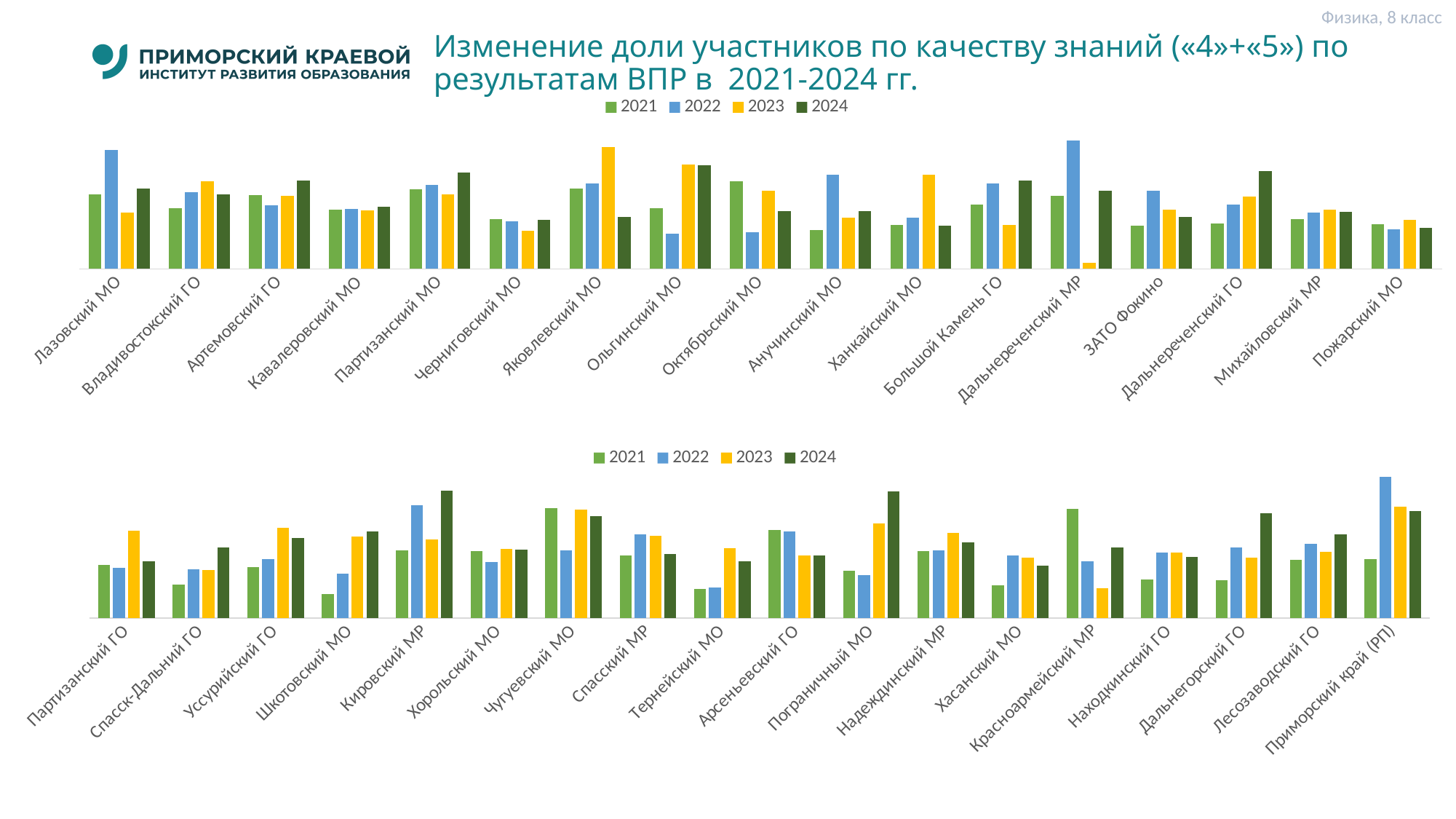
How many categories are shown on the x axis of the top chart? 17 How many series does the legend of the top chart list? 4 In the top chart, which year has the lowest bar for Дальнереченский МР? 2023 How many categories are shown on the x axis of the bottom chart? 18 In the top chart, for Лазовский МО, which is larger: the 2022 value or the 2023 value? 2022 What kind of chart is the top chart on the slide? Bar chart Which years are listed in the legend of the bottom chart? 2021, 2022, 2023, 2024 In the bottom chart, which year has the lowest bar for Красноармейский МР? 2023 In the top chart, which year has the highest bar for Яковлевский МО? 2023 In the top chart, which year has the highest bar for Дальнереченский МР? 2022 In the bottom chart, do the values for Шкотовский МО rise or fall from 2021 to 2024? Rise In the bottom chart, which category has the tallest 2022 bar? Приморский край (РП)